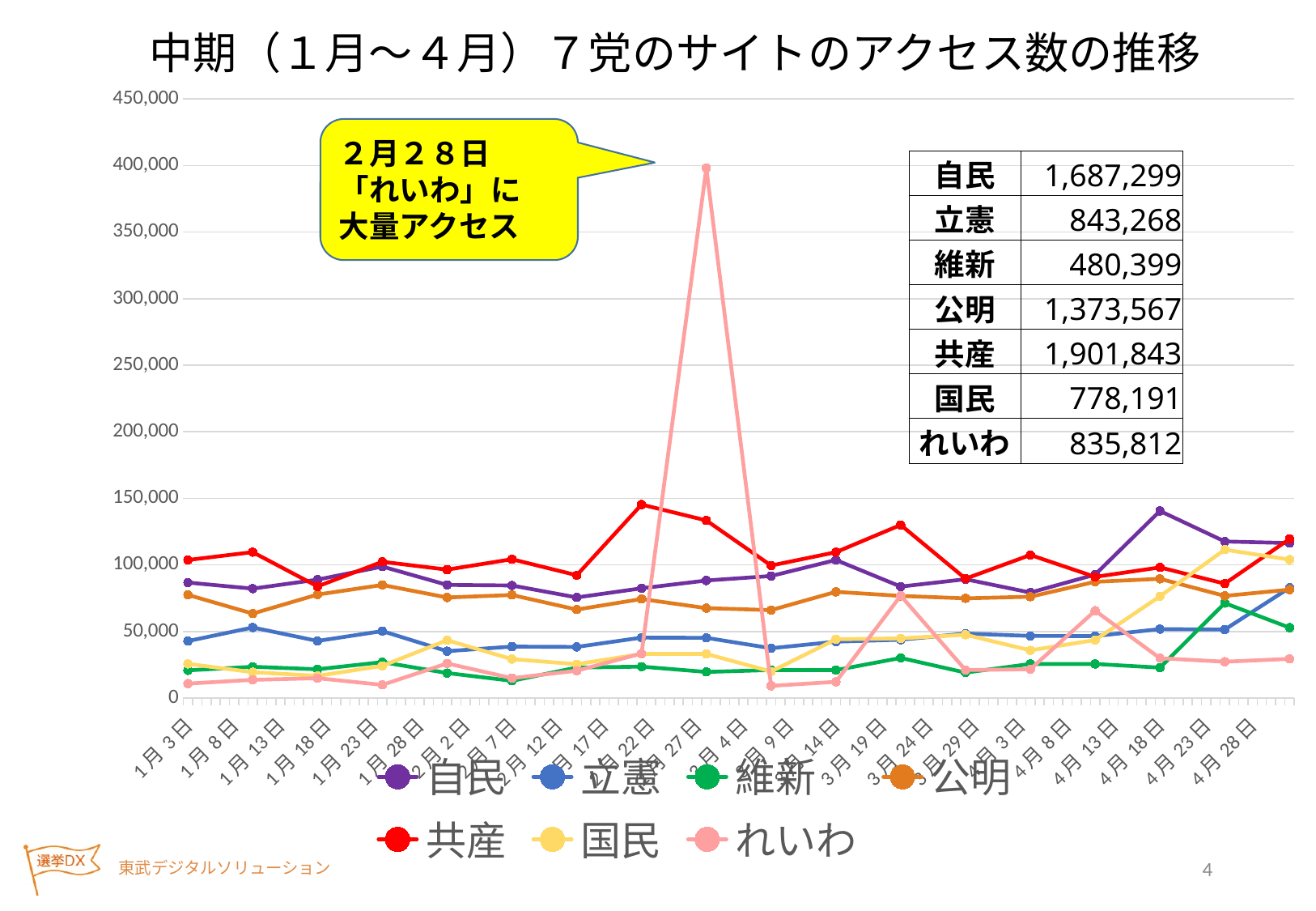
What is the title of the chart? 中期（１月～４月）７党のサイトのアクセス数の推移 According to the table on the slide, what is the total for 維新? 480,399 Which series has the highest single peak on the chart? れいわ Is the value for 共産 on 2月22日 greater or less than 100,000? greater What is the highest value shown on the vertical axis? 450,000 Is the value for 維新 on 1月3日 greater or less than 50,000? less On 2月22日, which series is higher, 共産 or 立憲? 共産 How many series does the legend list? 7 Is the peak value for れいわ around 2月27日 greater or less than 350,000? greater What kind of chart is shown on the slide? line chart According to the table on the slide, what is the total for 共産? 1,901,843